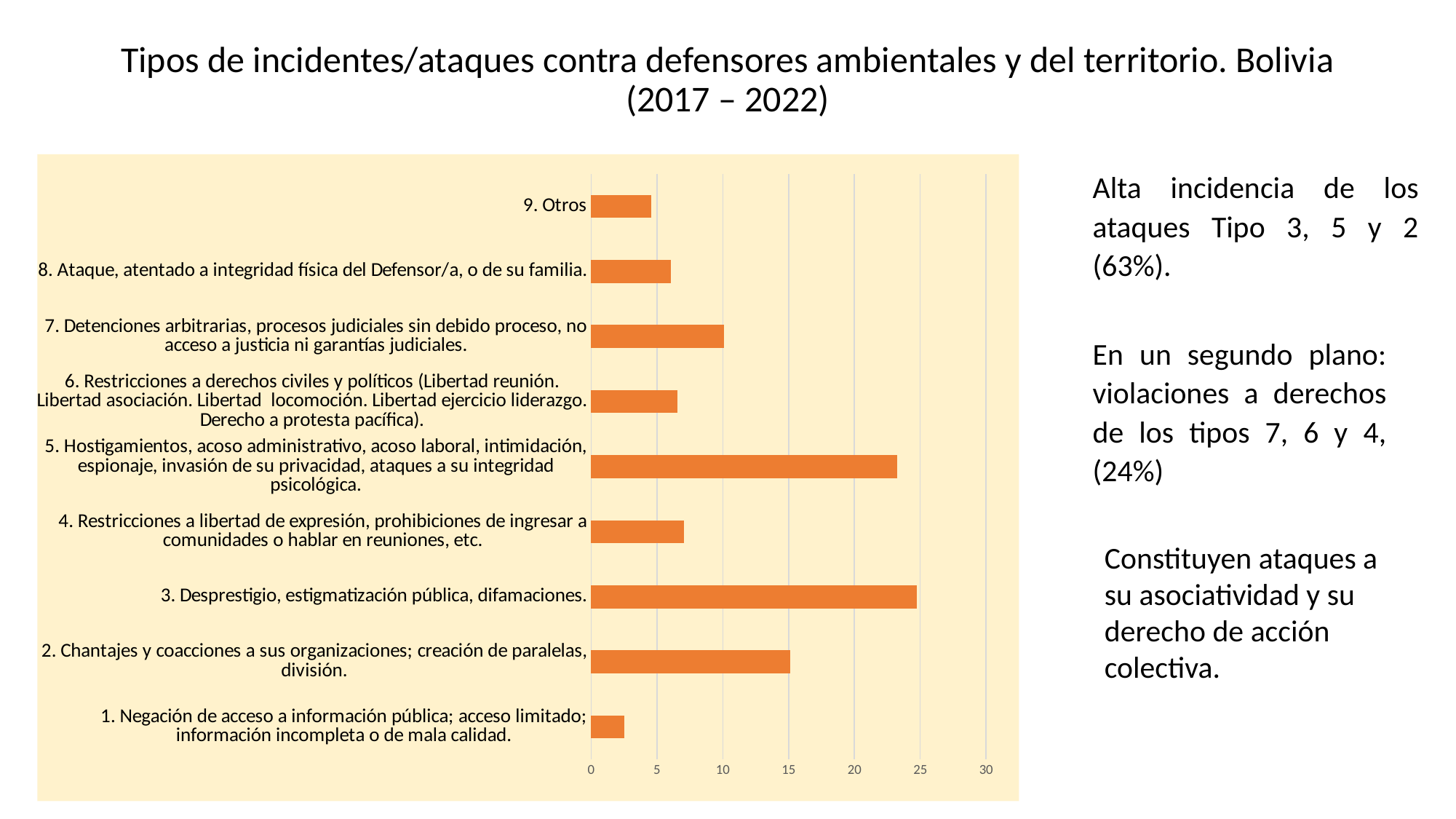
What kind of chart is shown on the slide? bar chart Which has a larger value: "2. Chantajes y coacciones a sus organizaciones..." or "7. Detenciones arbitrarias, procesos judiciales sin debido proceso..."? 2. Chantajes y coacciones a sus organizaciones; creación de paralelas, división. How many categories of incidents/attacks are plotted in the chart? 9 What is the title of the chart on the slide? Tipos de incidentes/ataques contra defensores ambientales y del territorio. Bolivia (2017 – 2022) Which has a larger value: "4. Restricciones a libertad de expresión..." or "1. Negación de acceso a información pública..."? 4. Restricciones a libertad de expresión, prohibiciones de ingresar a comunidades o hablar en reuniones, etc. Is the value for "5. Hostigamientos, acoso administrativo, acoso laboral, intimidación..." greater or less than 20? greater Is the value for "7. Detenciones arbitrarias, procesos judiciales sin debido proceso..." greater or less than 15? less Which category has the lowest value in the chart? 1. Negación de acceso a información pública; acceso limitado; información incompleta o de mala calidad. Which category has the highest value in the chart? 3. Desprestigio, estigmatización pública, difamaciones. Is the value for "8. Ataque, atentado a integridad física del Defensor/a, o de su familia." greater or less than 5? greater